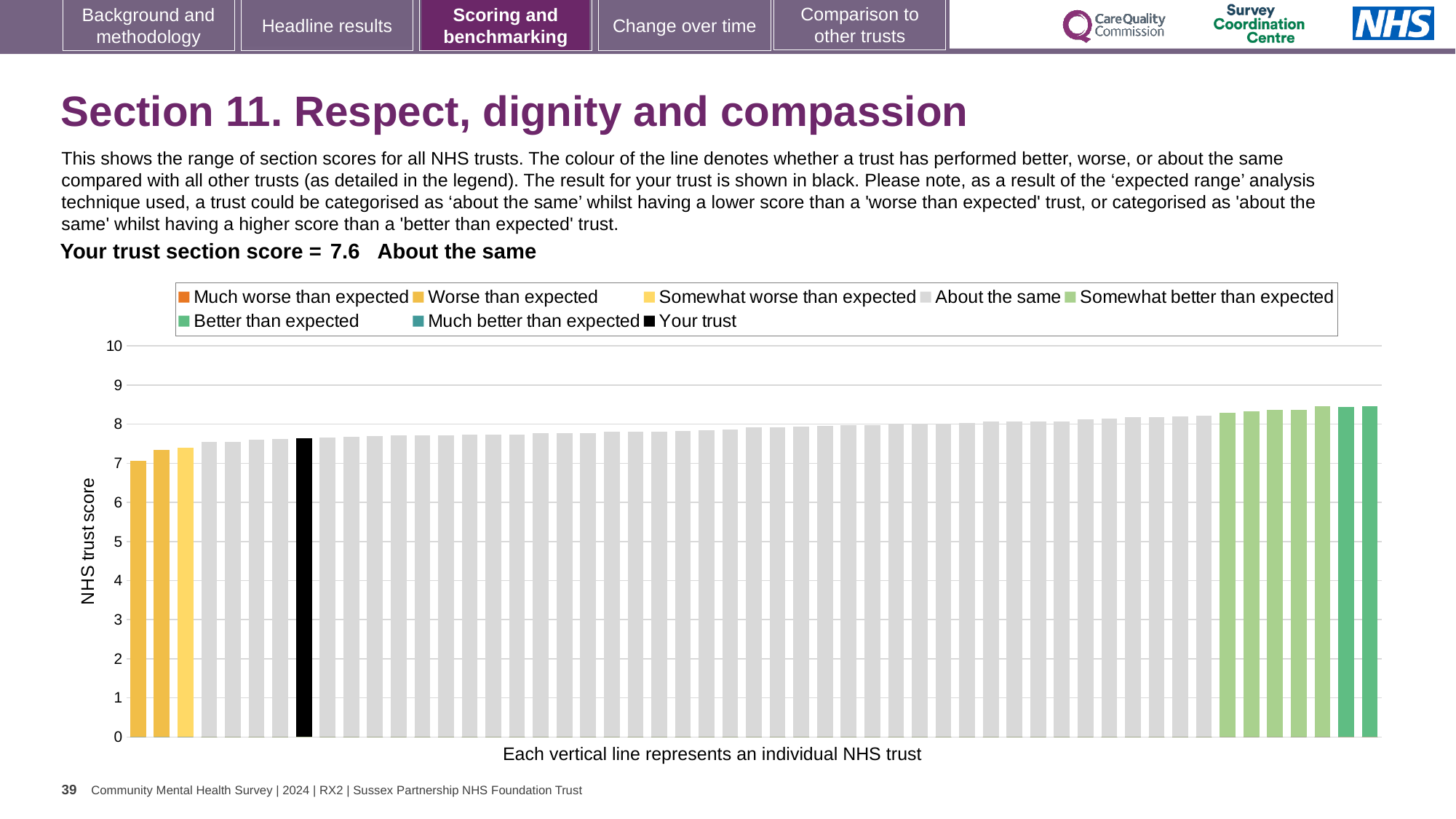
How many bars are coloured as 'Better than expected' (the darker green bars)? 2 What colour is the bar representing your trust? Black How many bars are coloured as 'Somewhat better than expected' (the light green bars)? 5 Is the value for your trust (the black bar) greater or less than 7? greater What is the section score for your trust shown on the slide? 7.6 Is the leftmost bar higher or lower than the black bar for your trust? Lower Do the bar values rise or fall from left to right along the x axis? Rise Is the value of the rightmost bar greater or less than 8? greater How many entries does the chart legend list? 8 Is the value of the leftmost bar greater or less than 8? less What kind of chart is shown on the slide? Bar chart What is the label on the vertical axis of the chart? NHS trust score